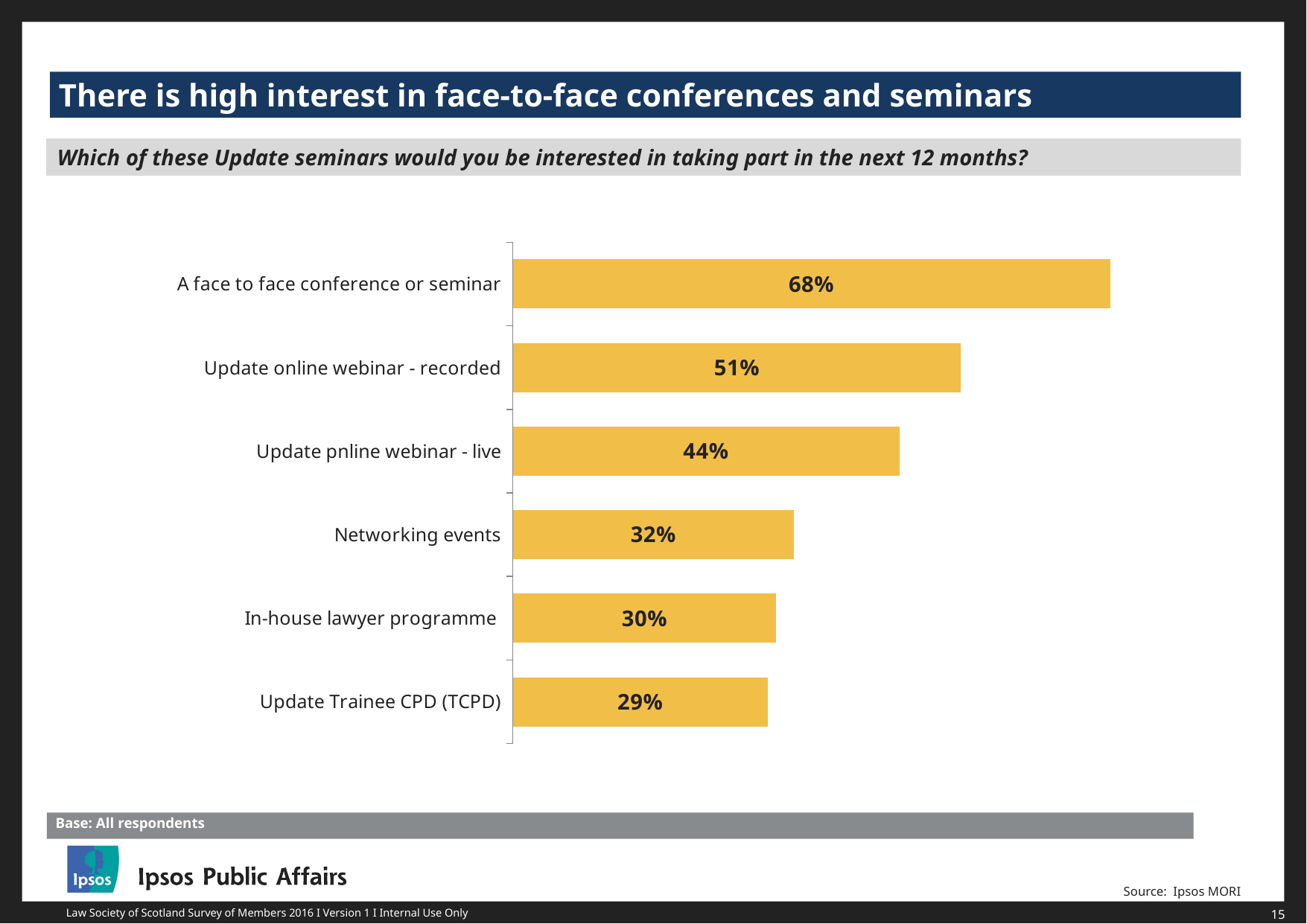
What is the value for Update online webinar - recorded? 51% What is the value for Update Trainee CPD (TCPD)? 29% Which option has the lowest level of interest? Update Trainee CPD (TCPD) What percentage of respondents are interested in a face to face conference or seminar? 68% What is the value for Networking events? 32% What is the difference between the value for a face to face conference or seminar and the value for Update online webinar - recorded? 17% Which option has the highest level of interest? A face to face conference or seminar Which is larger: the value for Update online webinar - recorded or the value for Update pnline webinar - live? Update online webinar - recorded What colour are the bars in the chart? Yellow How many options are shown in the chart? 6 What is the difference between the value for Networking events and the value for In-house lawyer programme? 2% What kind of chart is shown on the slide? Bar chart